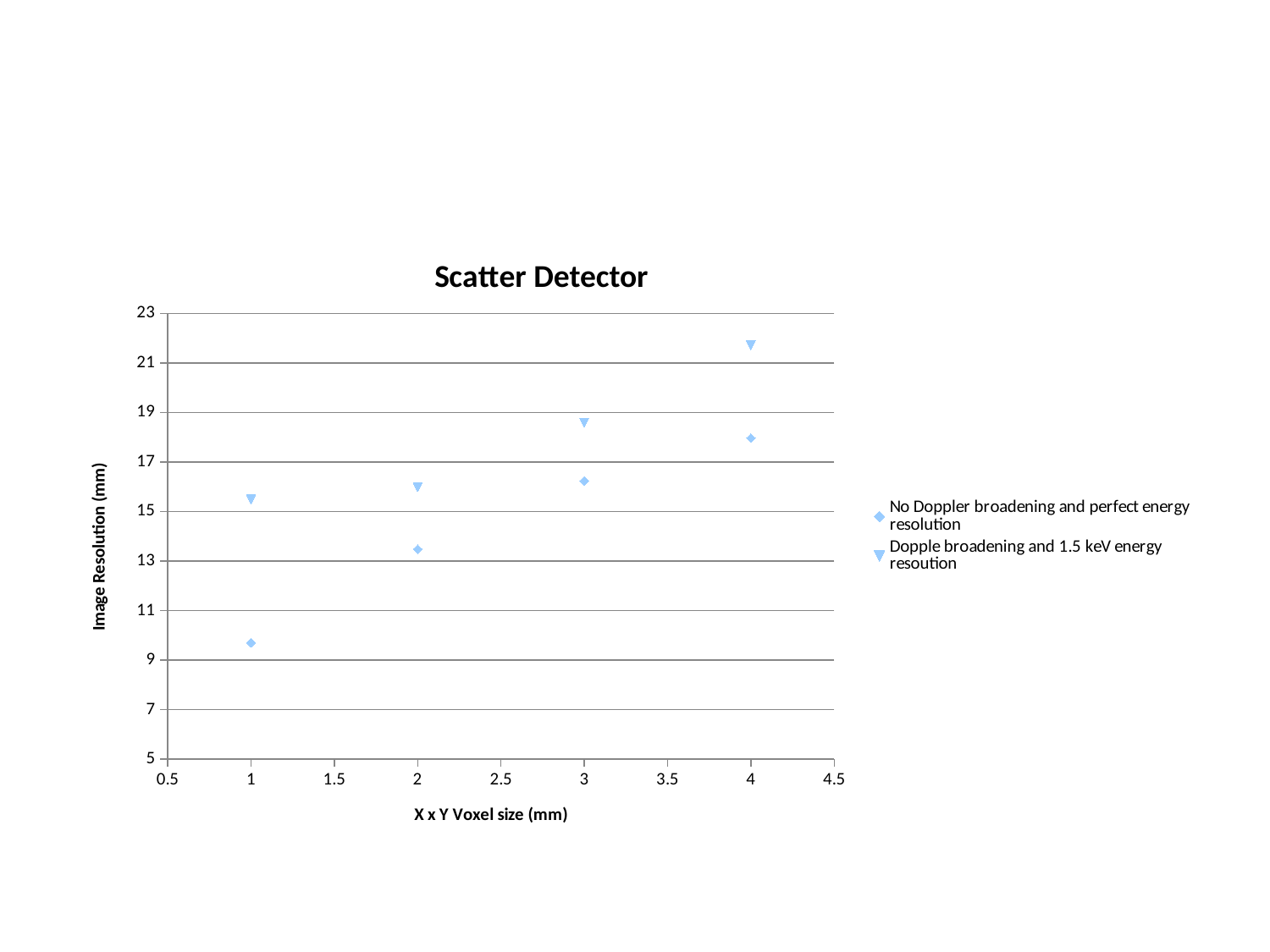
For the 'No Doppler broadening and perfect energy resolution' series, at which voxel size is the image resolution highest? 4 How many data points are plotted for the 'No Doppler broadening and perfect energy resolution' series? 4 How many series does the legend list? 2 What is the title of the chart? Scatter Detector At a voxel size of 2 mm, which series has the higher image resolution value? Dopple broadening and 1.5 keV energy resoution Is the image resolution for 'No Doppler broadening and perfect energy resolution' at a voxel size of 1 mm greater or less than 11? less Is the image resolution for 'Dopple broadening and 1.5 keV energy resoution' at a voxel size of 3 mm greater or less than 17? greater Is the image resolution for 'No Doppler broadening and perfect energy resolution' at a voxel size of 2 mm greater or less than 15? less Do the image resolution values rise or fall as the voxel size increases along the x axis? rise For the 'Dopple broadening and 1.5 keV energy resoution' series, at which voxel size is the image resolution lowest? 1 What kind of chart is shown on the slide? scatter chart